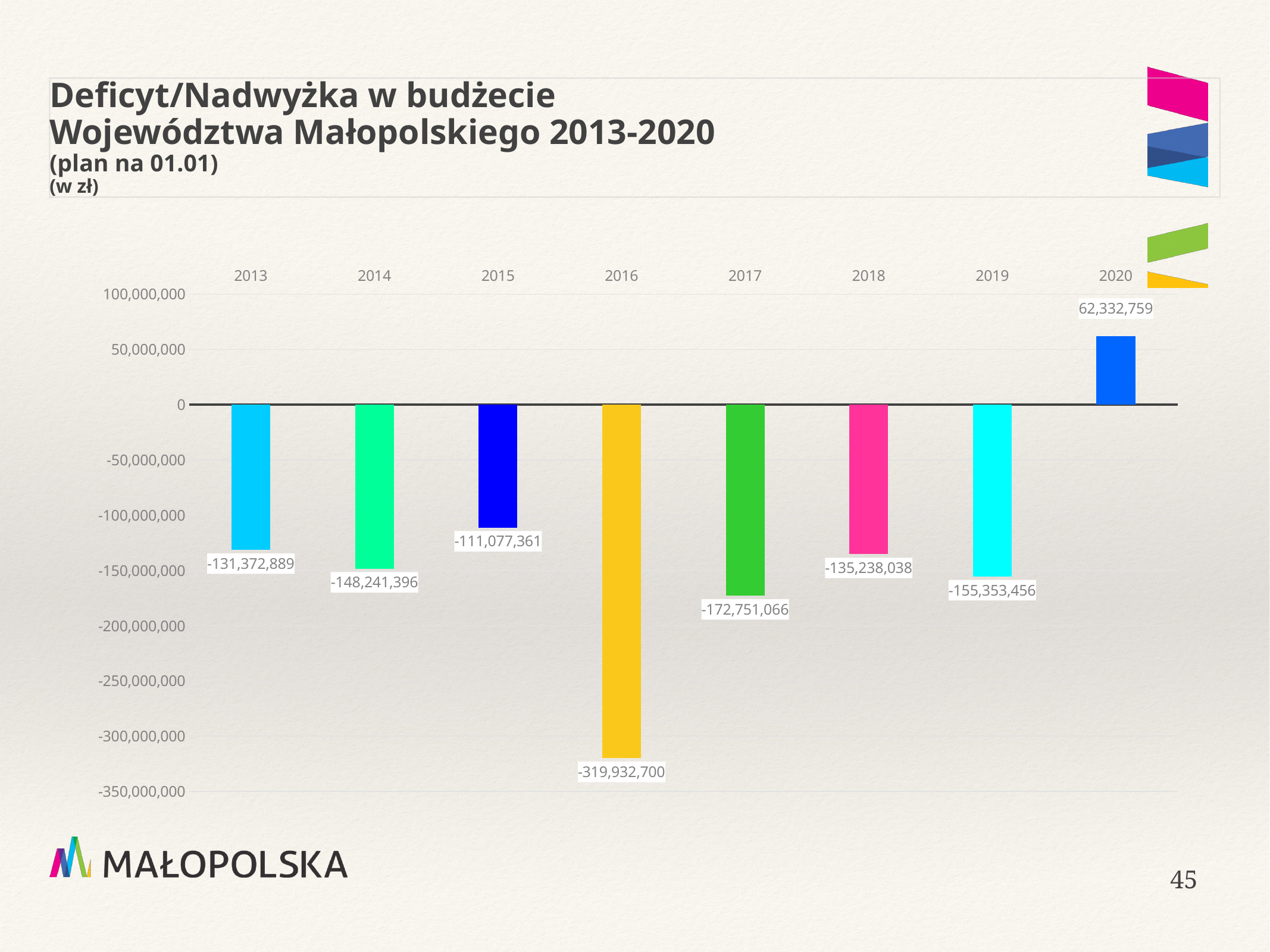
What is the value for 2013? -131,372,889 What is the difference between the values for 2019 and 2014? 7,112,060 How many years are shown on the x axis? 8 What is the value for 2020? 62,332,759 How many years show a positive value (surplus)? 1 What kind of chart is shown on the slide? Bar chart Which year has the lowest value? 2016 Which year has the highest value? 2020 Which value is larger, 2015 or 2017? 2015 What is the value for 2016? -319,932,700 What is the title of the chart? Deficyt/Nadwyżka w budżecie Województwa Małopolskiego 2013-2020 (plan na 01.01) (w zł) What is the value for 2018? -135,238,038